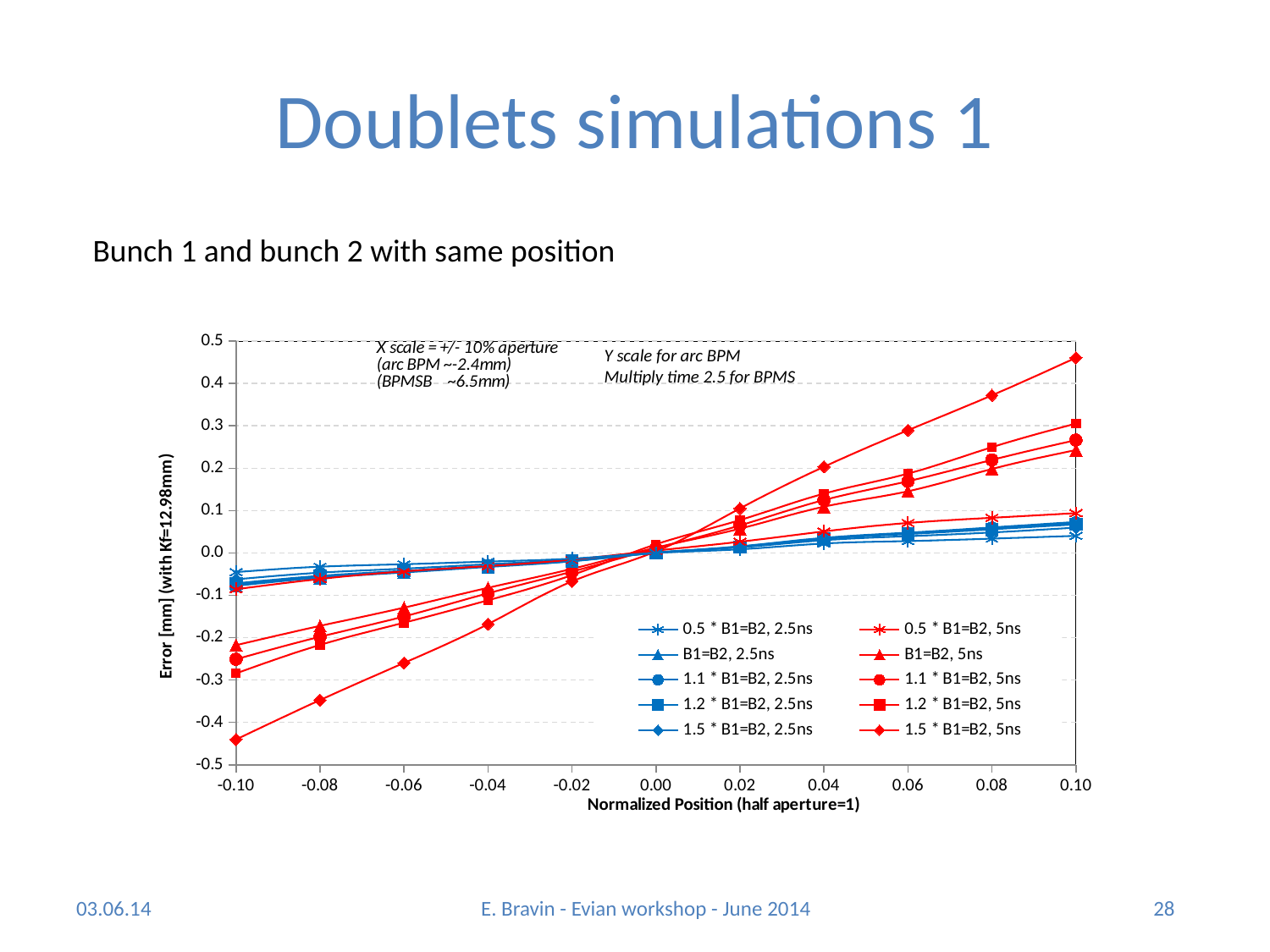
Which series reaches the highest value at Normalized Position 0.10? 1.5 * B1=B2, 5ns What kind of chart is shown on the slide? line chart What colour are the 5ns series drawn in on the chart? red Is the value of the 1.5 * B1=B2, 5ns series at Normalized Position 0.06 greater or less than 0.2? greater Is the value of the 1.2 * B1=B2, 5ns series at Normalized Position -0.10 greater or less than -0.2? less Which series has the lowest value at Normalized Position -0.10? 1.5 * B1=B2, 5ns How many series does the chart legend list? 10 Is the value of the 1.5 * B1=B2, 5ns series at Normalized Position 0.10 greater or less than 0.4? greater What is the title of the x axis of the chart? Normalized Position (half aperture=1) Do the values of the 1.5 * B1=B2, 5ns series rise or fall as Normalized Position increases from -0.10 to 0.10? rise At Normalized Position 0.10, which is larger: the 1.5 * B1=B2, 5ns series or the 1.2 * B1=B2, 5ns series? 1.5 * B1=B2, 5ns